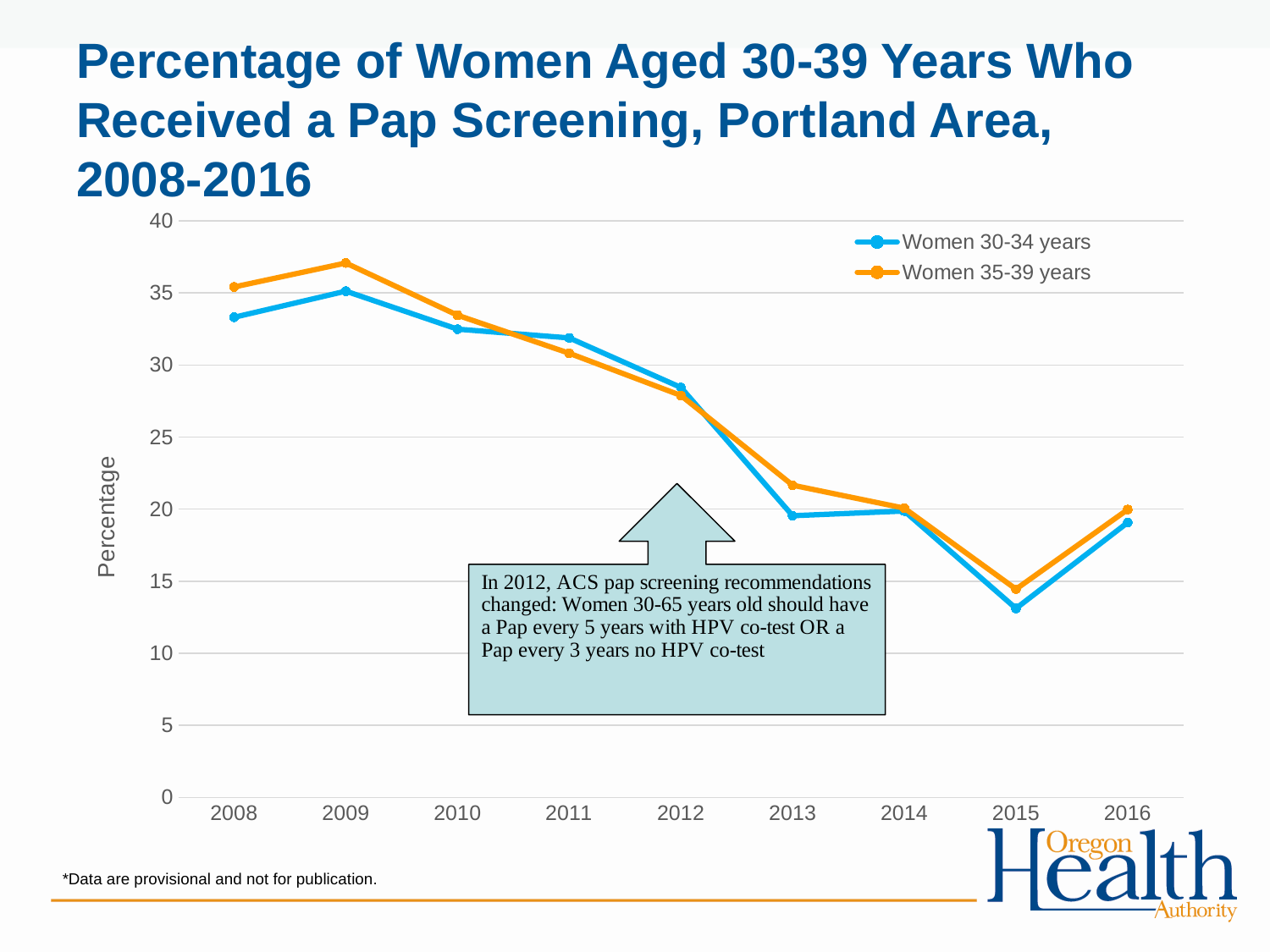
Is the value for Women 30-34 years in 2012 greater or less than 25? greater How many series does the legend list? 2 Is the value for Women 35-39 years in 2009 greater or less than 35? greater In which year is the value for Women 30-34 years lowest? 2015 In 2013, which series has the higher value, Women 30-34 years or Women 35-39 years? Women 35-39 years In which year is the value for Women 35-39 years highest? 2009 Is the value for Women 30-34 years in 2015 greater or less than 15? less How many years are plotted along the x axis? 9 In 2009, which series has the higher value, Women 30-34 years or Women 35-39 years? Women 35-39 years Do the values for Women 30-34 years rise or fall from 2009 to 2015? fall What is the label on the y axis? Percentage What kind of chart is shown on the slide? line chart